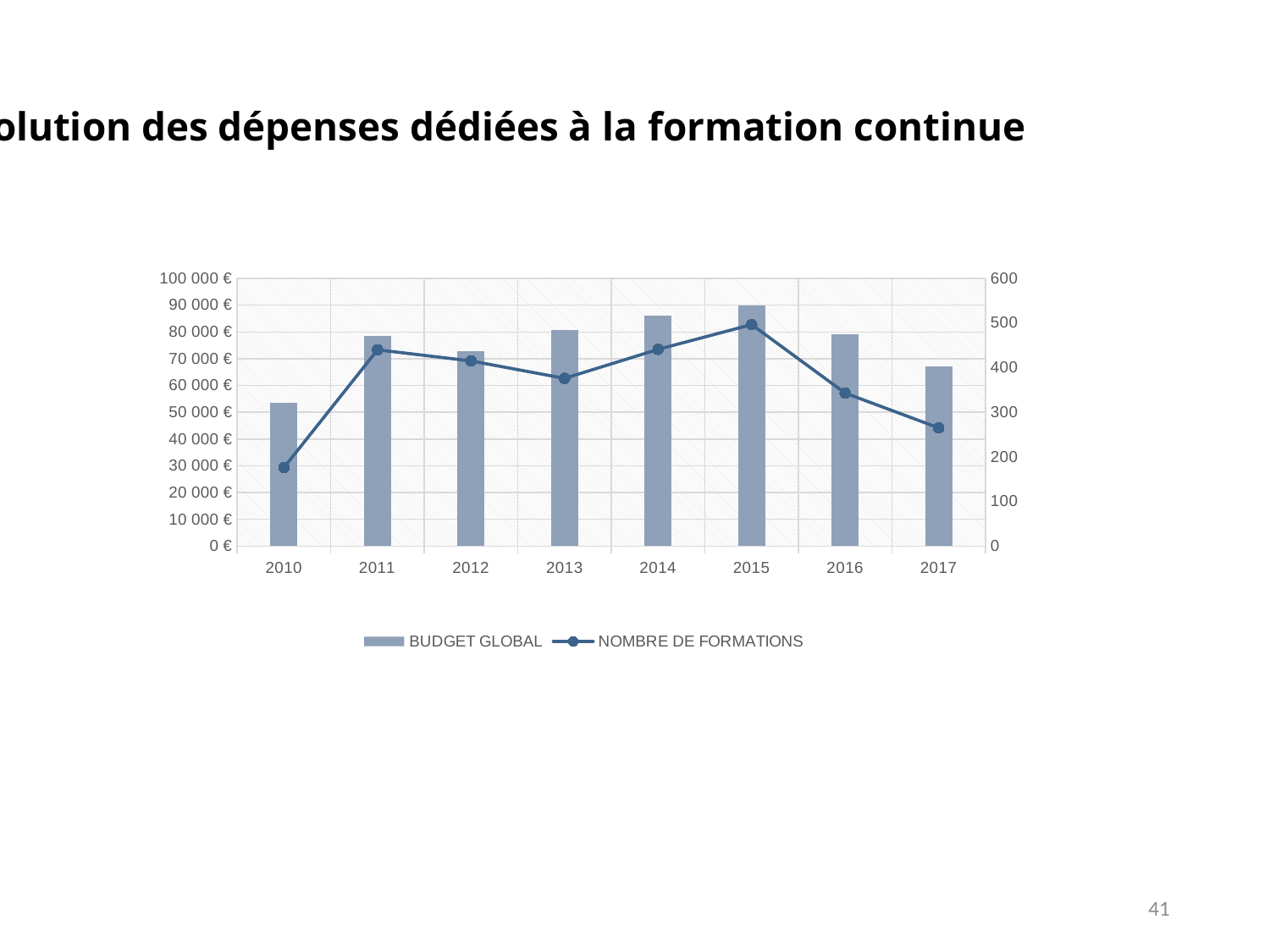
Is the BUDGET GLOBAL value for 2015 greater or less than 80 000 €? greater Is the BUDGET GLOBAL value for 2010 greater or less than 60 000 €? less Is the NOMBRE DE FORMATIONS value for 2010 greater or less than 200? less Which year has the lowest BUDGET GLOBAL bar? 2010 Which year has the highest BUDGET GLOBAL bar? 2015 Which year has the larger BUDGET GLOBAL, 2012 or 2014? 2014 What kind of chart is shown on the slide? Combined bar and line chart How many years are shown on the x axis of the chart? 8 How many series does the chart legend list? 2 Does the BUDGET GLOBAL rise or fall from 2015 to 2017? fall Which year has the lowest value for NOMBRE DE FORMATIONS? 2010